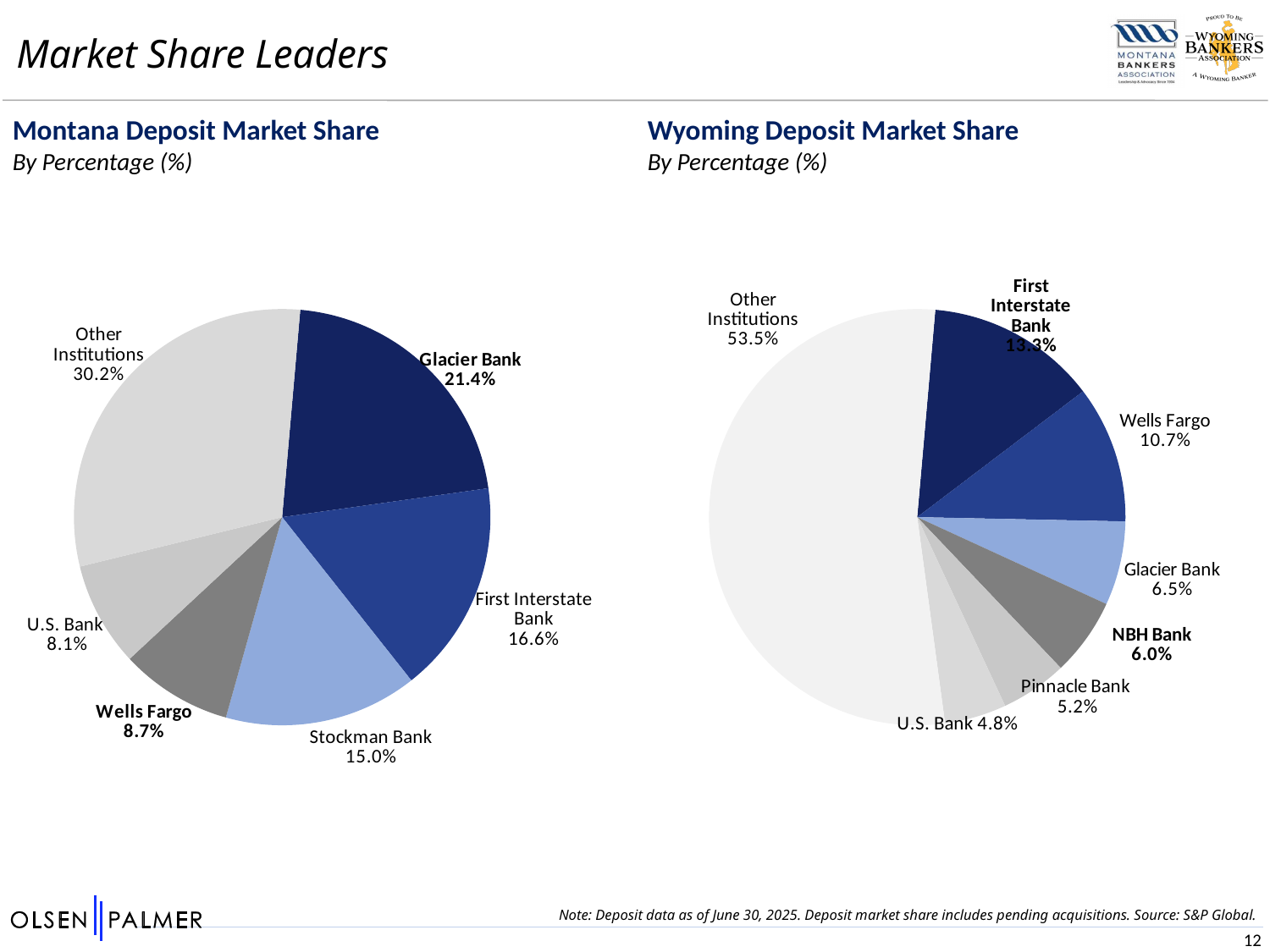
In the Wyoming Deposit Market Share chart, which is larger: Glacier Bank's share or NBH Bank's share? Glacier Bank In the Wyoming Deposit Market Share chart, what is the share for Pinnacle Bank? 5.2% In the Montana Deposit Market Share chart, what is the combined share of Wells Fargo and U.S. Bank? 16.8% In the Wyoming Deposit Market Share chart, which slice is the smallest? U.S. Bank In the Wyoming Deposit Market Share chart, what is the share for Wells Fargo? 10.7% In the Montana Deposit Market Share chart, what is the share for Glacier Bank? 21.4% In the Montana Deposit Market Share chart, which named bank has the largest share? Glacier Bank In the Montana Deposit Market Share chart, what is the share for Stockman Bank? 15.0% How many slices does the Wyoming Deposit Market Share pie chart have? 7 In the Montana Deposit Market Share chart, what is the difference between Glacier Bank's share and First Interstate Bank's share? 4.8% How many slices does the Montana Deposit Market Share pie chart have? 6 What type of chart is used for the Wyoming Deposit Market Share? Pie chart